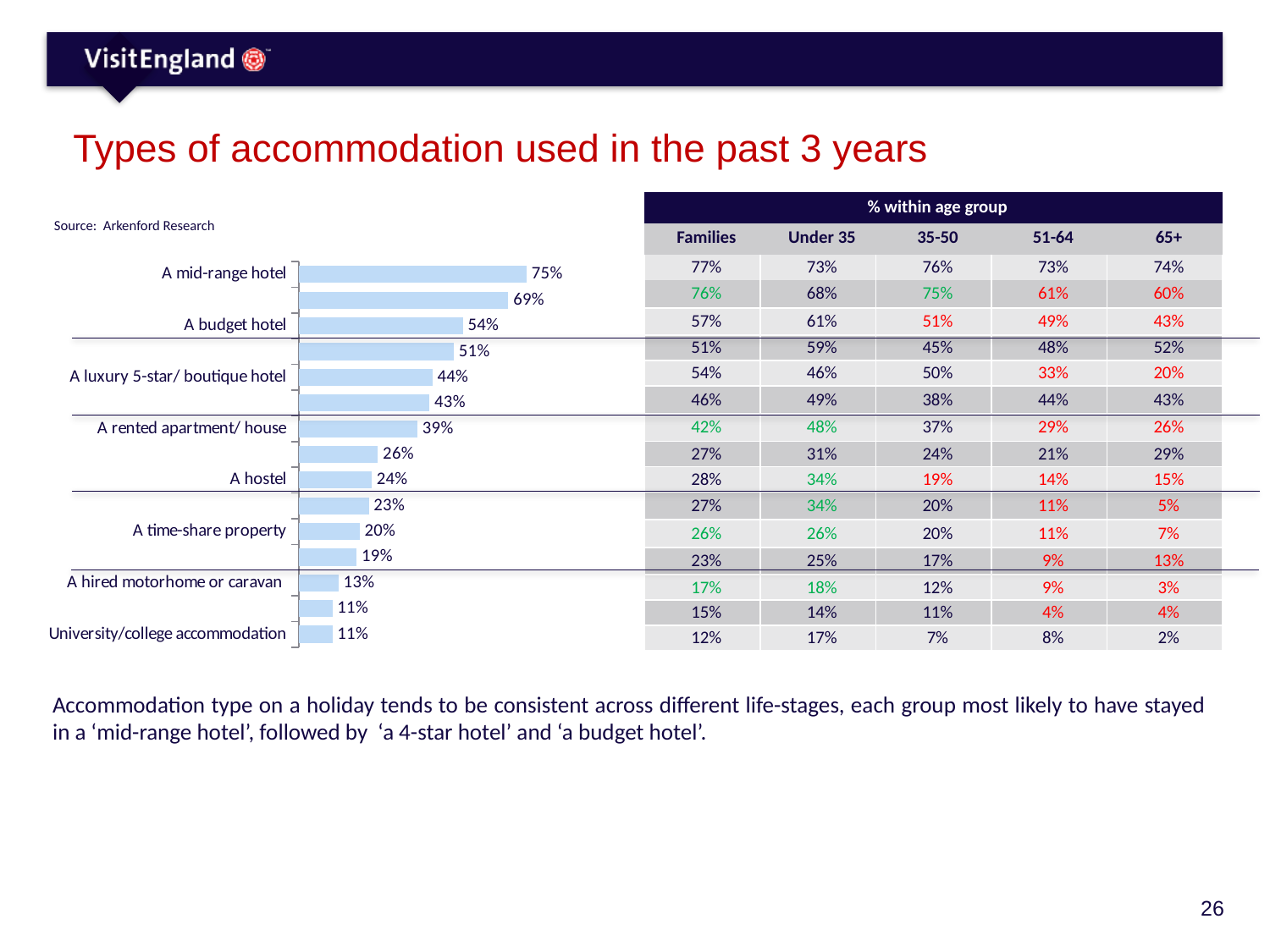
What is the value for 'A luxury 5-star/ boutique hotel'? 44% Which has a larger value, 'A time-share property' or 'A hostel'? A hostel What is the value for 'A rented apartment/ house'? 39% What is the value for 'A budget hotel'? 54% What is the difference between the values for 'A mid-range hotel' and 'A budget hotel'? 21% What is the value for 'A hired motorhome or caravan'? 13% What is the value for 'A hostel'? 24% How many bars are plotted in the chart? 15 What type of chart is shown on the slide? bar chart Which accommodation type has the highest value in the chart? A mid-range hotel Do the bar values rise or fall going from the top of the chart to the bottom? fall What is the value for 'A mid-range hotel'? 75%